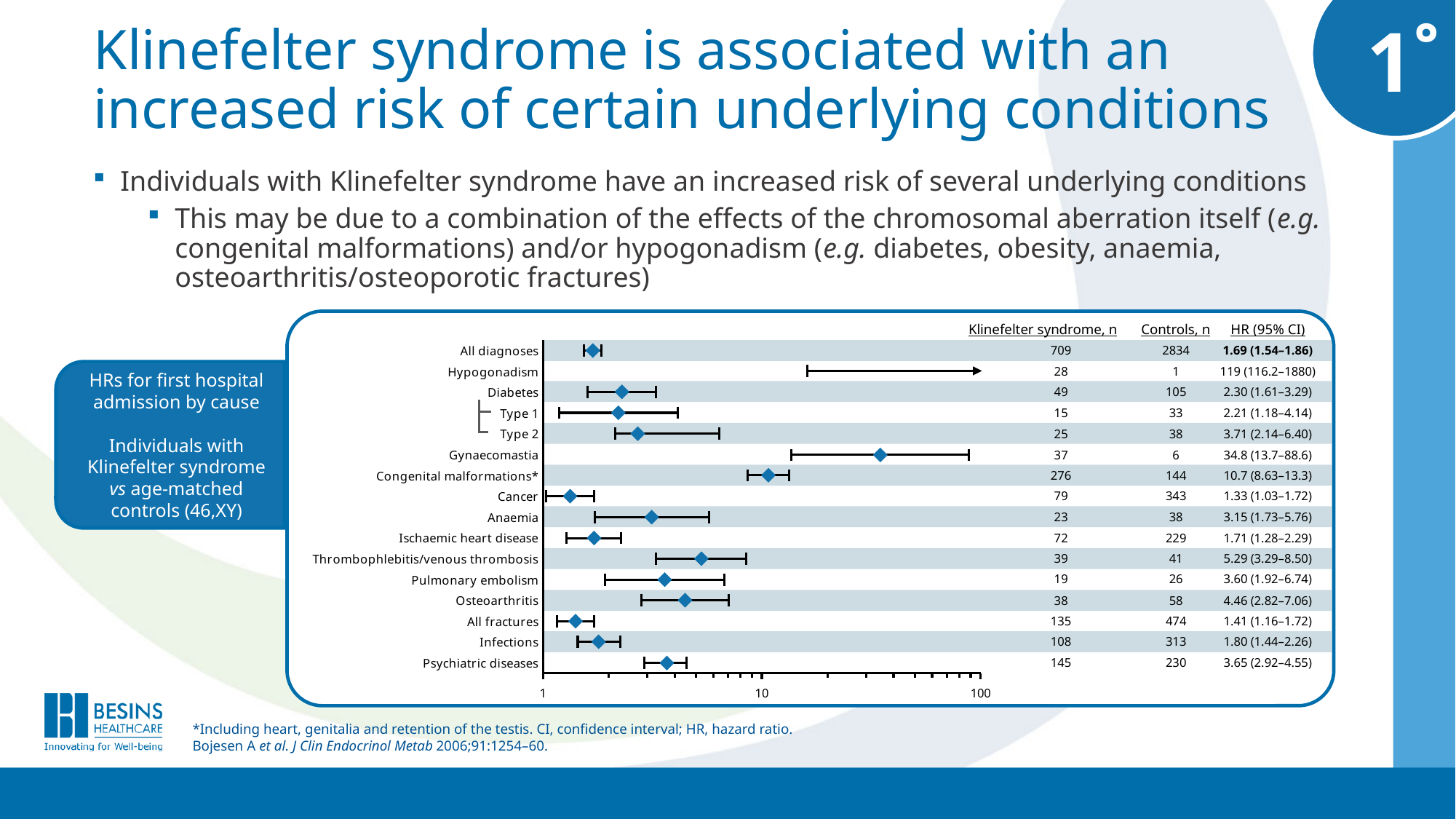
Which cause has the lowest hazard ratio? Cancer What kind of chart is shown on the slide? Forest plot Which cause has the highest hazard ratio? Hypogonadism What is the hazard ratio (95% CI) for All diagnoses? 1.69 (1.54–1.86) How many causes (rows) are plotted in the forest plot? 16 Is the hazard ratio for Thrombophlebitis/venous thrombosis greater or less than 10? less What is the number of controls for Psychiatric diseases? 230 Which has a higher hazard ratio, Anaemia or Pulmonary embolism? Pulmonary embolism What is the difference between the number of controls and the number of individuals with Klinefelter syndrome for All diagnoses? 2125 How many individuals with Klinefelter syndrome had a first hospital admission for Congenital malformations? 276 What is the hazard ratio (95% CI) for Gynaecomastia? 34.8 (13.7–88.6) What are the three column headings of the table to the right of the plot? Klinefelter syndrome, n; Controls, n; HR (95% CI)